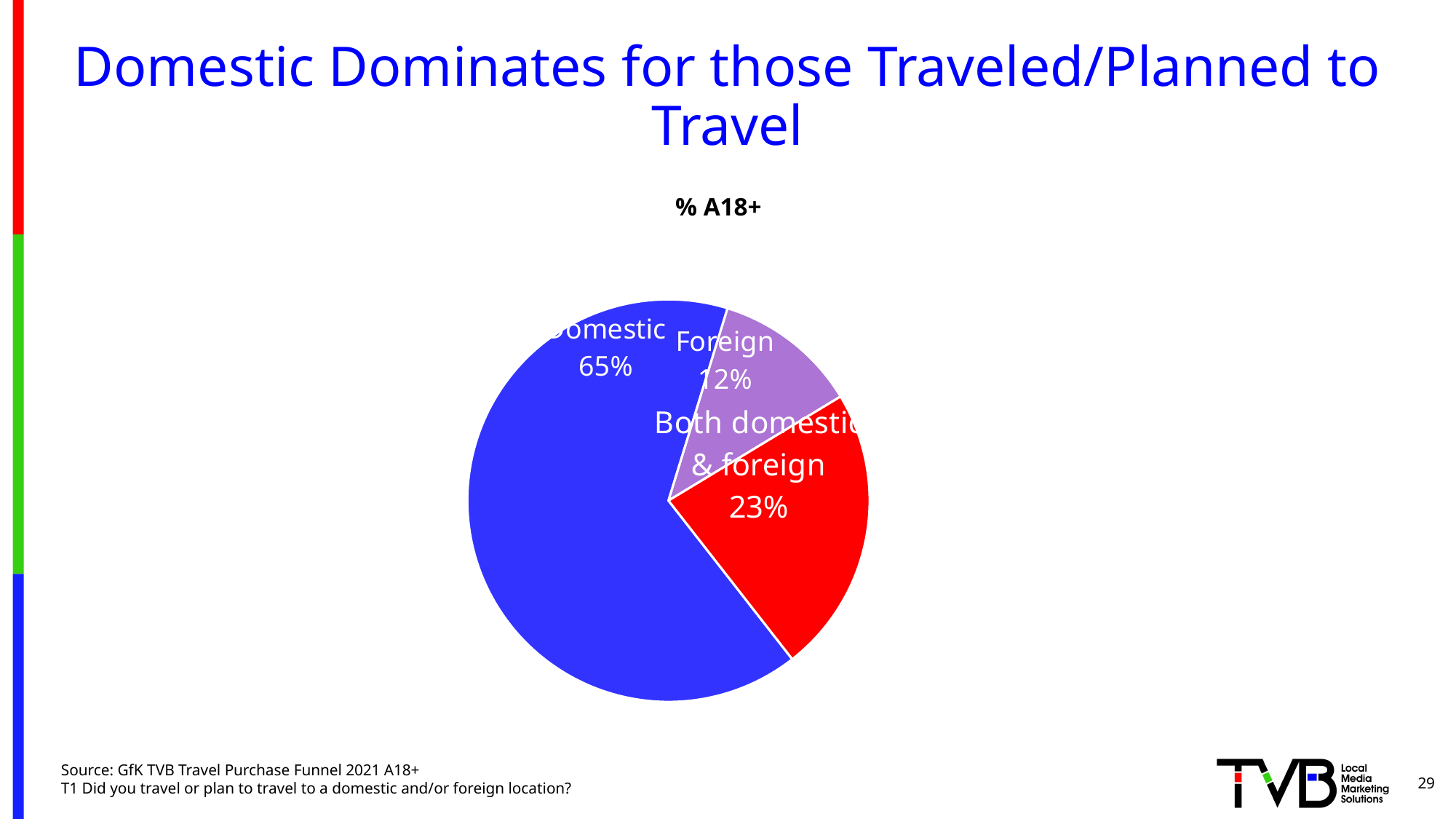
What is the difference between the Both domestic & foreign and Foreign values? 11% Which slice of the pie is the smallest? Foreign What is the title of the chart? % A18+ Which slice of the pie is the largest? Domestic What colour is the Domestic slice? blue What is the difference between the Domestic and Foreign values? 53% What kind of chart is shown on the slide? pie chart What is the value for Domestic? 65% What is the value for Foreign? 12% How many slices does the pie chart have? 3 What is the value for Both domestic & foreign? 23% Which is larger, Both domestic & foreign or Foreign? Both domestic & foreign